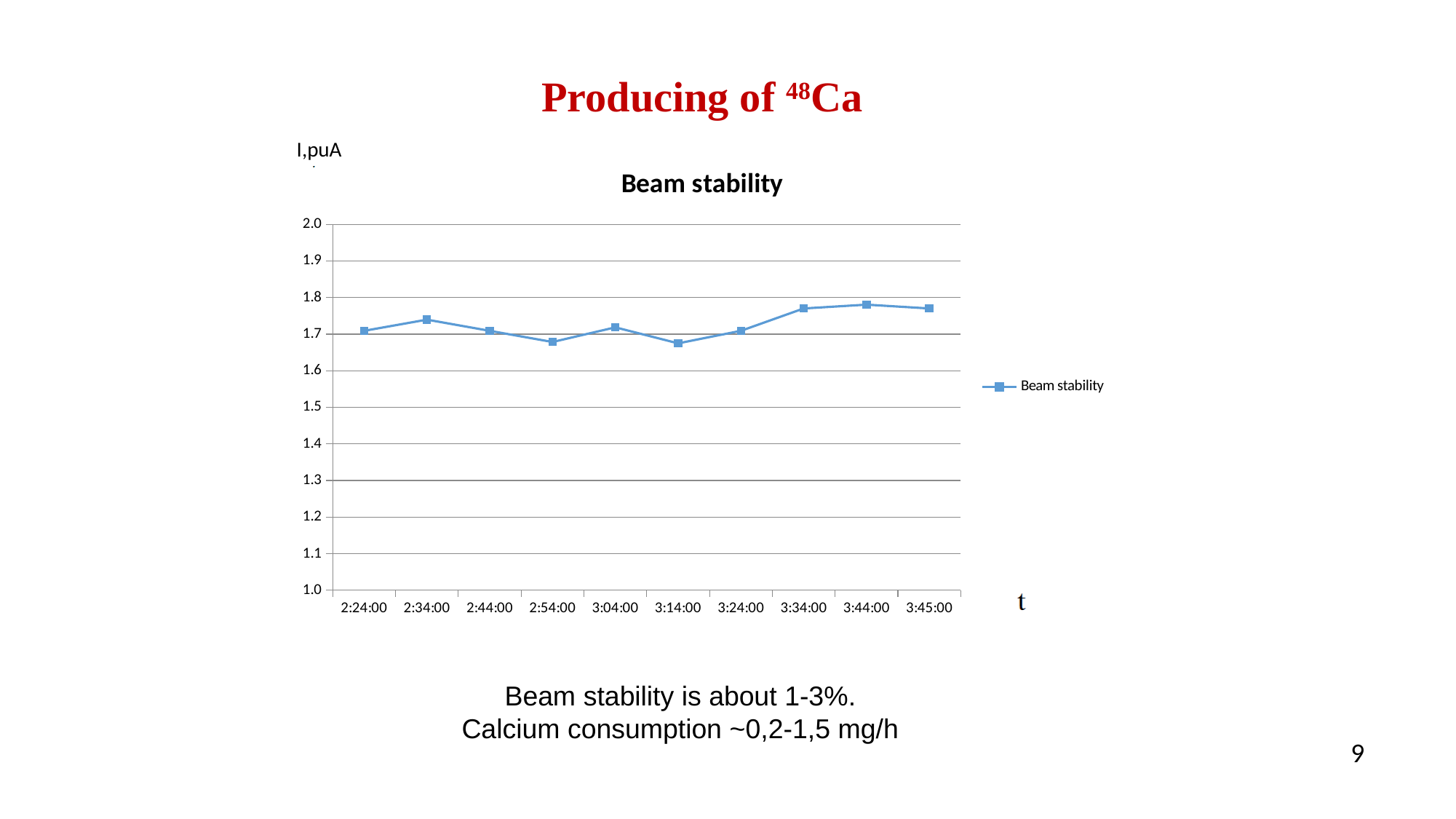
How many time points are plotted on the x axis? 10 What kind of chart is shown on the slide? line chart Which is larger, the value at 3:44:00 or the value at 2:54:00? 3:44:00 Does the beam current rise or fall overall from 2:24:00 to 3:45:00? rise How many series does the legend list? 1 Is the value at 3:44:00 greater or less than 1.8? less Is the value at 3:34:00 greater or less than 1.7? greater Which is larger, the value at 3:14:00 or the value at 3:34:00? 3:34:00 What label is shown on the vertical axis of the chart? I,puA Is the value at 3:14:00 greater or less than 1.7? less What is the title of the chart? Beam stability